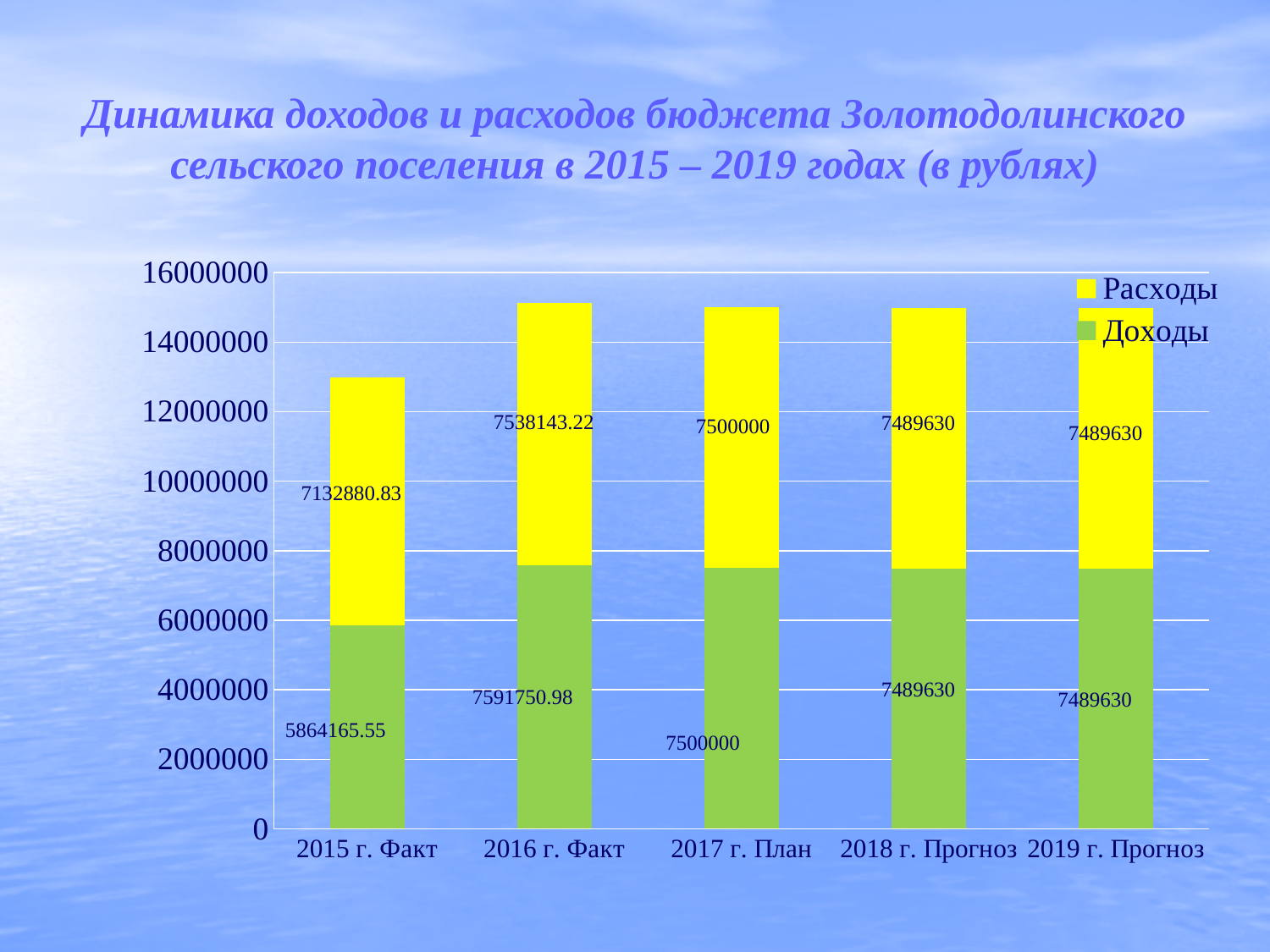
Which category has the highest value of Доходы? 2016 г. Факт How many series does the legend list? 2 Which series is shown in yellow? Расходы What is the difference between Расходы and Доходы for 2015 г. Факт? 1268715.28 What is the value of Доходы for 2015 г. Факт? 5864165.55 How many categories are shown on the x axis? 5 What is the value of Доходы for 2017 г. План? 7500000 What type of chart is shown on the slide? Stacked bar chart What is the total of the stacked bar for 2017 г. План? 15000000 What is the value of Расходы for 2016 г. Факт? 7538143.22 Which category has the lowest value of Расходы? 2015 г. Факт What is the value of Расходы for 2019 г. Прогноз? 7489630